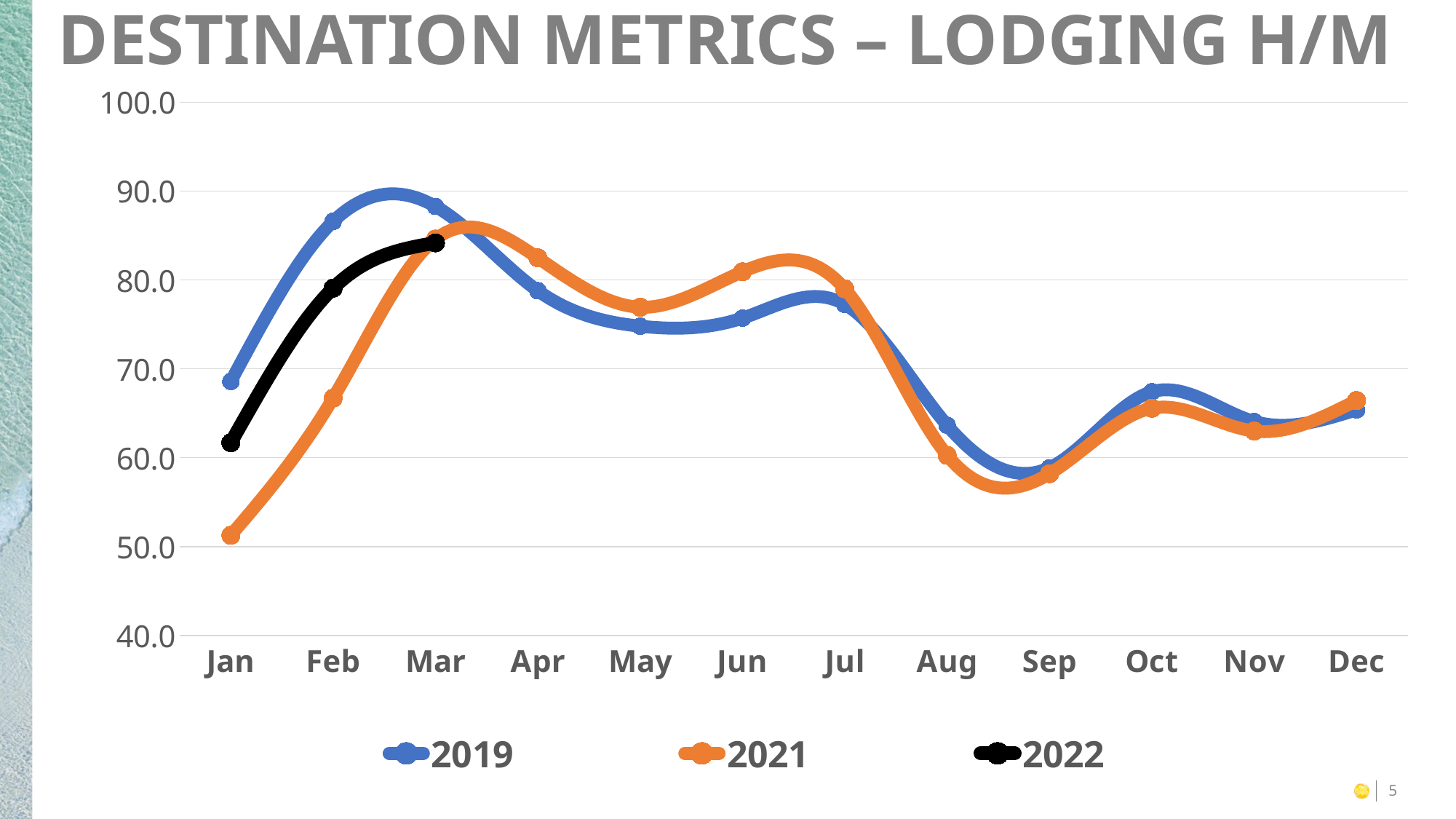
Is the value for 2022 in Feb greater or less than 70? greater How many months are shown on the x axis? 12 In Jan, which series has the higher value, 2019 or 2021? 2019 How many series does the legend list? 3 In which month does the 2021 series reach its lowest value? Jan Is the value for 2019 in Sep greater or less than 60? less What kind of chart is shown on the slide? Line chart How many data points are plotted for the 2022 series? 3 Is the value for 2021 in Jan greater or less than 60? less Does the 2022 series rise or fall from Jan to Mar? Rise What is the title of the slide? DESTINATION METRICS – LODGING H/M